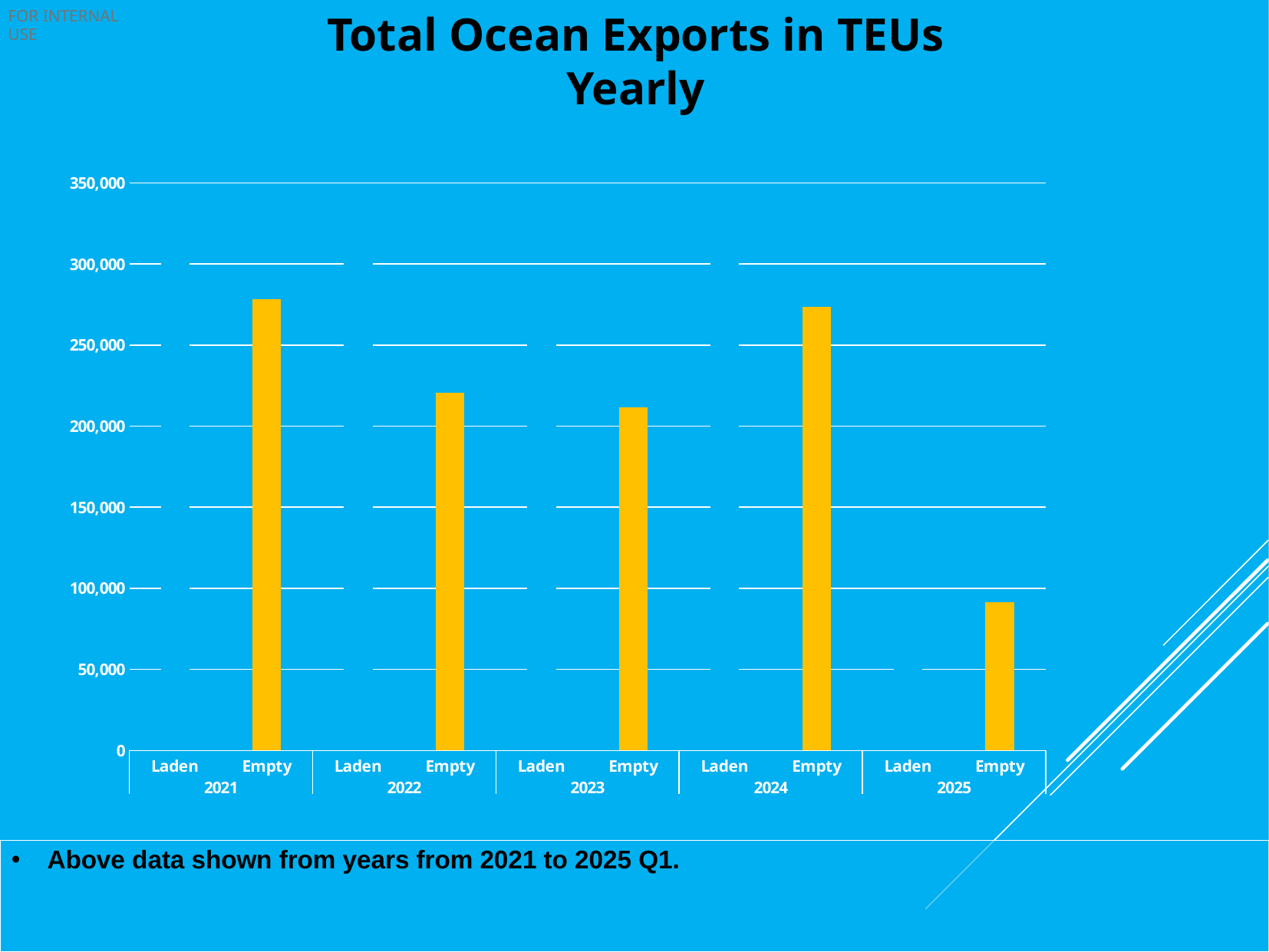
Is the Empty value for 2024 greater or less than 300,000? less Which is larger, the Empty value for 2021 or the Empty value for 2025? 2021 Is the Empty value for 2023 greater or less than 250,000? less Is the Empty value for 2021 greater or less than 250,000? greater Which is larger, the Empty value for 2024 or the Empty value for 2022? 2024 Does the Empty value rise or fall from 2024 to 2025? Fall Which year has the lowest Empty bar? 2025 What kind of chart is shown on the slide? Bar chart What is the title of the chart? Total Ocean Exports in TEUs Yearly How many years are shown along the x axis of the chart? 5